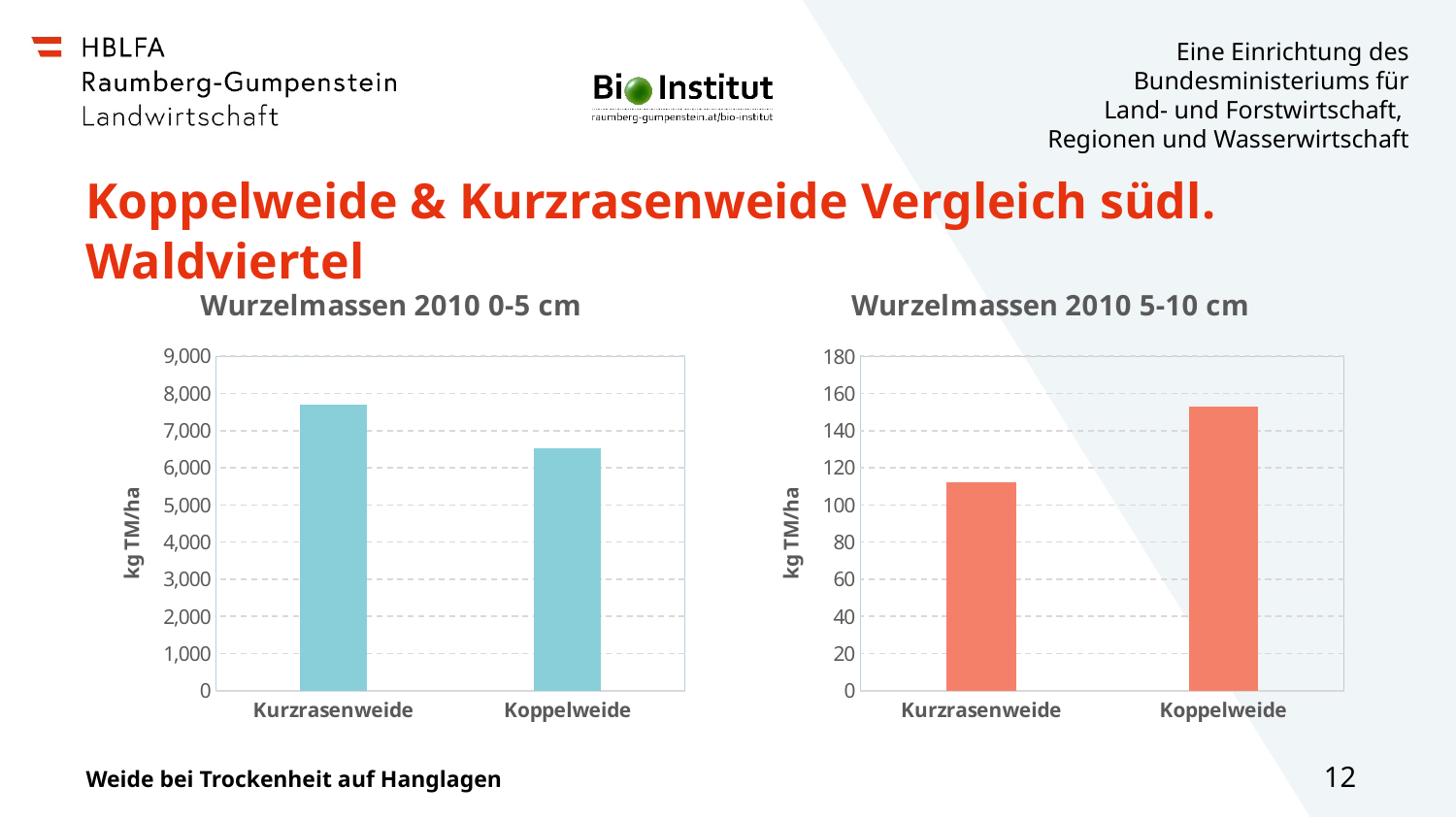
How many categories are shown in the chart titled 'Wurzelmassen 2010 0-5 cm'? 2 In the chart titled 'Wurzelmassen 2010 5-10 cm', is the value for Kurzrasenweide greater or less than 120? less In the chart titled 'Wurzelmassen 2010 0-5 cm', is the value for Kurzrasenweide greater or less than 7,000? greater What kind of chart is the chart titled 'Wurzelmassen 2010 5-10 cm'? bar chart In the chart titled 'Wurzelmassen 2010 5-10 cm', is the value for Koppelweide greater or less than 140? greater In the chart titled 'Wurzelmassen 2010 5-10 cm', which category has the highest value? Koppelweide In the chart titled 'Wurzelmassen 2010 5-10 cm', which is larger, the value for Kurzrasenweide or Koppelweide? Koppelweide In the chart titled 'Wurzelmassen 2010 0-5 cm', which category has the highest value? Kurzrasenweide In the chart titled 'Wurzelmassen 2010 5-10 cm', which category has the lowest value? Kurzrasenweide In the chart titled 'Wurzelmassen 2010 0-5 cm', which category has the lowest value? Koppelweide What is the y-axis label of the chart titled 'Wurzelmassen 2010 0-5 cm'? kg TM/ha